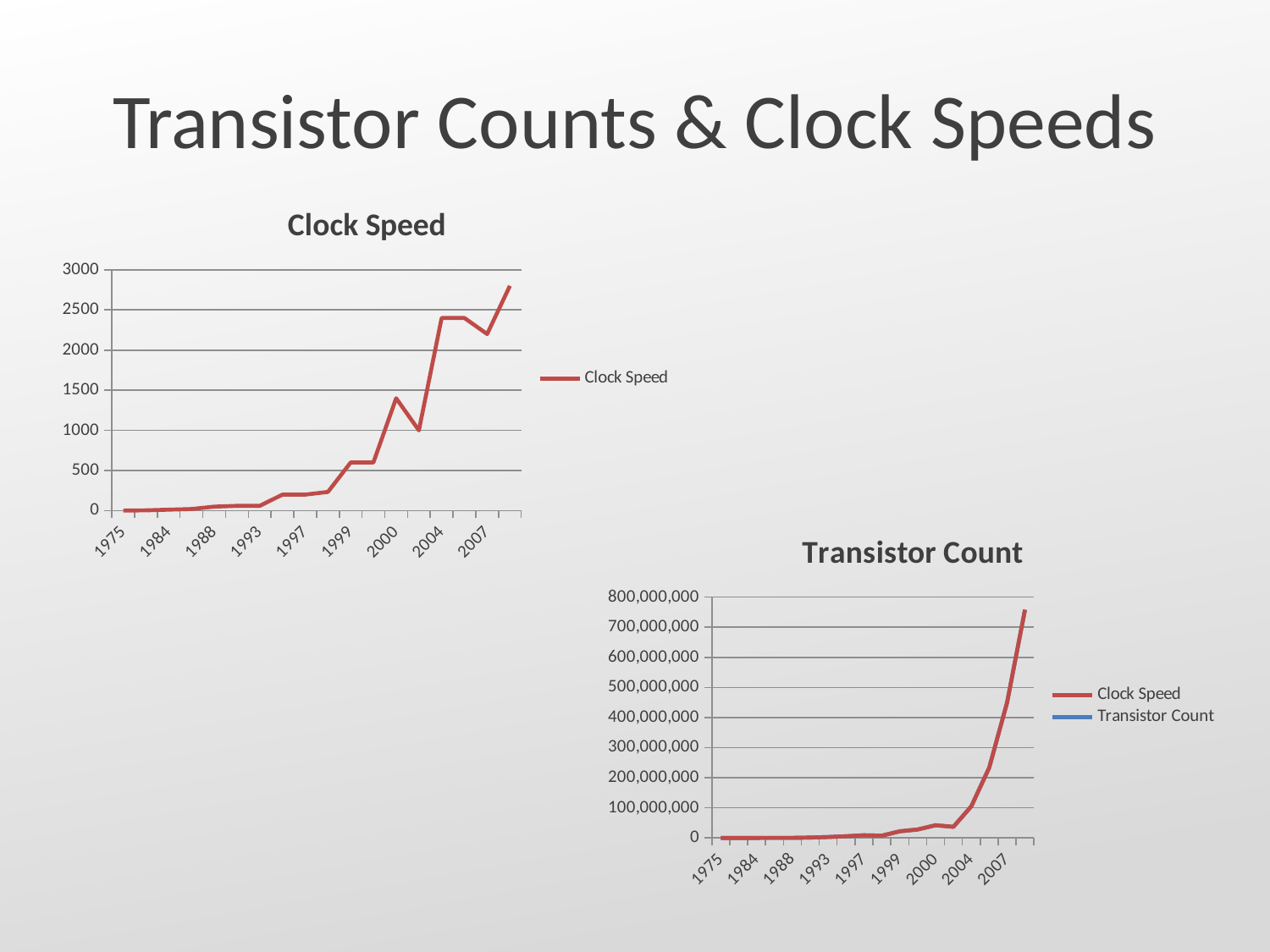
On the Clock Speed chart, is the value for 1999 greater or less than 500? greater How many series does the legend of the Transistor Count chart list? 2 What kind of chart is the Transistor Count chart? line chart What kind of chart is the Clock Speed chart? line chart On the Clock Speed chart, is the value for 1975 greater or less than 500? less On the Transistor Count chart, is the highest plotted value greater or less than 700,000,000? greater On the Clock Speed chart, do the values generally rise or fall from 1975 to the right end of the x axis? rise What is the title of the chart on the left of the slide? Clock Speed On the Transistor Count chart, do the values generally rise or fall along the x axis? rise On the Clock Speed chart, which is larger, the value for 2004 or the value for 1975? 2004